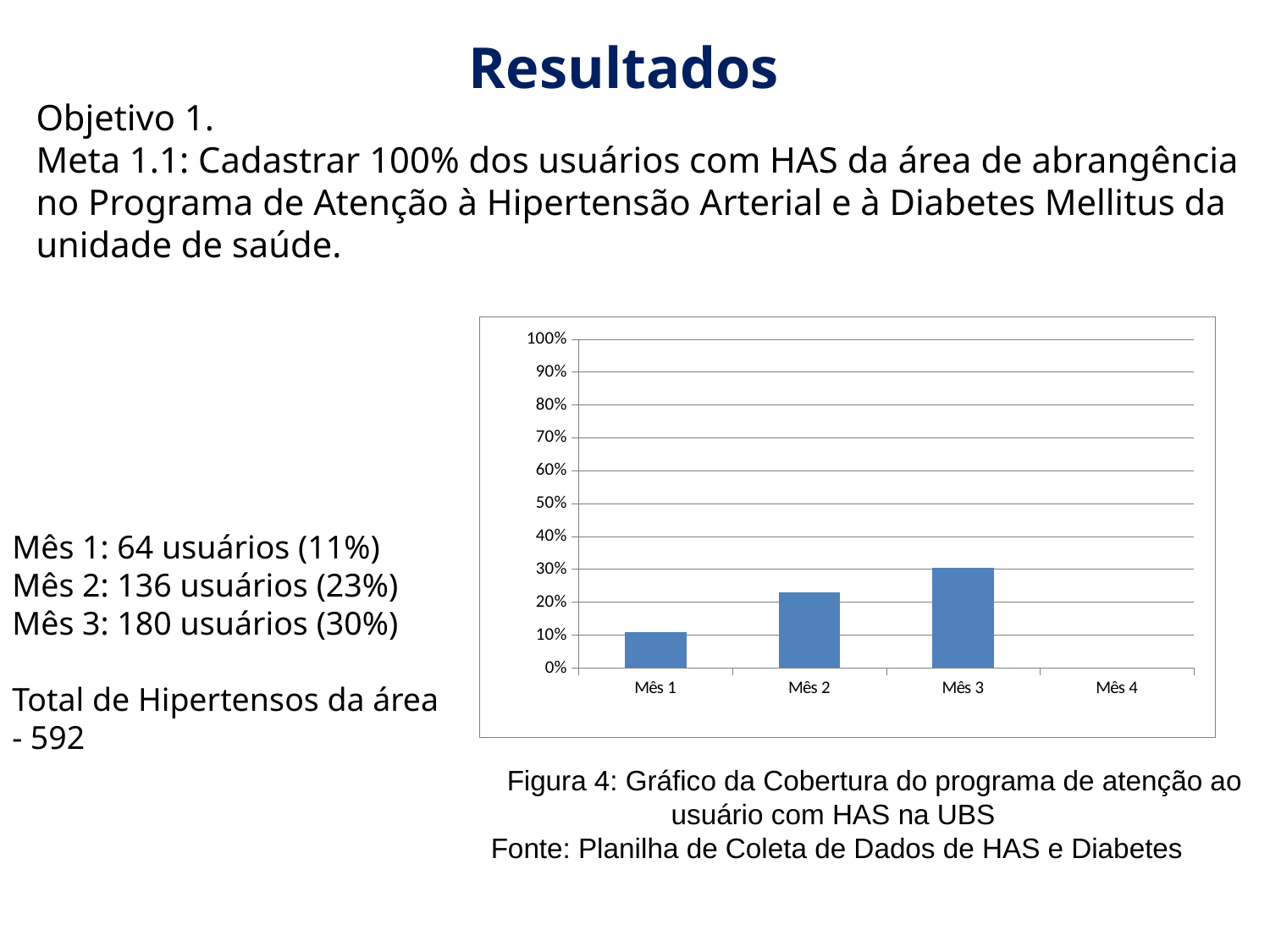
How many month categories are shown on the x axis of the chart? 4 According to the slide, what is the difference in percentage points between the coverage in Mês 3 and Mês 1? 19% Which month has the highest bar in the chart? Mês 3 Is the value for Mês 2 greater or less than 30%? less Is the value for Mês 3 greater or less than 20%? greater What kind of chart is shown on the slide? bar chart Is the value for Mês 1 greater or less than 20%? less Which is larger, the value for Mês 2 or the value for Mês 3? Mês 3 According to the slide, what percentage coverage was reached in Mês 3? 30% Do the bar values rise or fall from Mês 1 to Mês 3? rise Of the months that have a bar plotted, which has the lowest value? Mês 1 What is the highest value shown on the chart's y axis? 100%